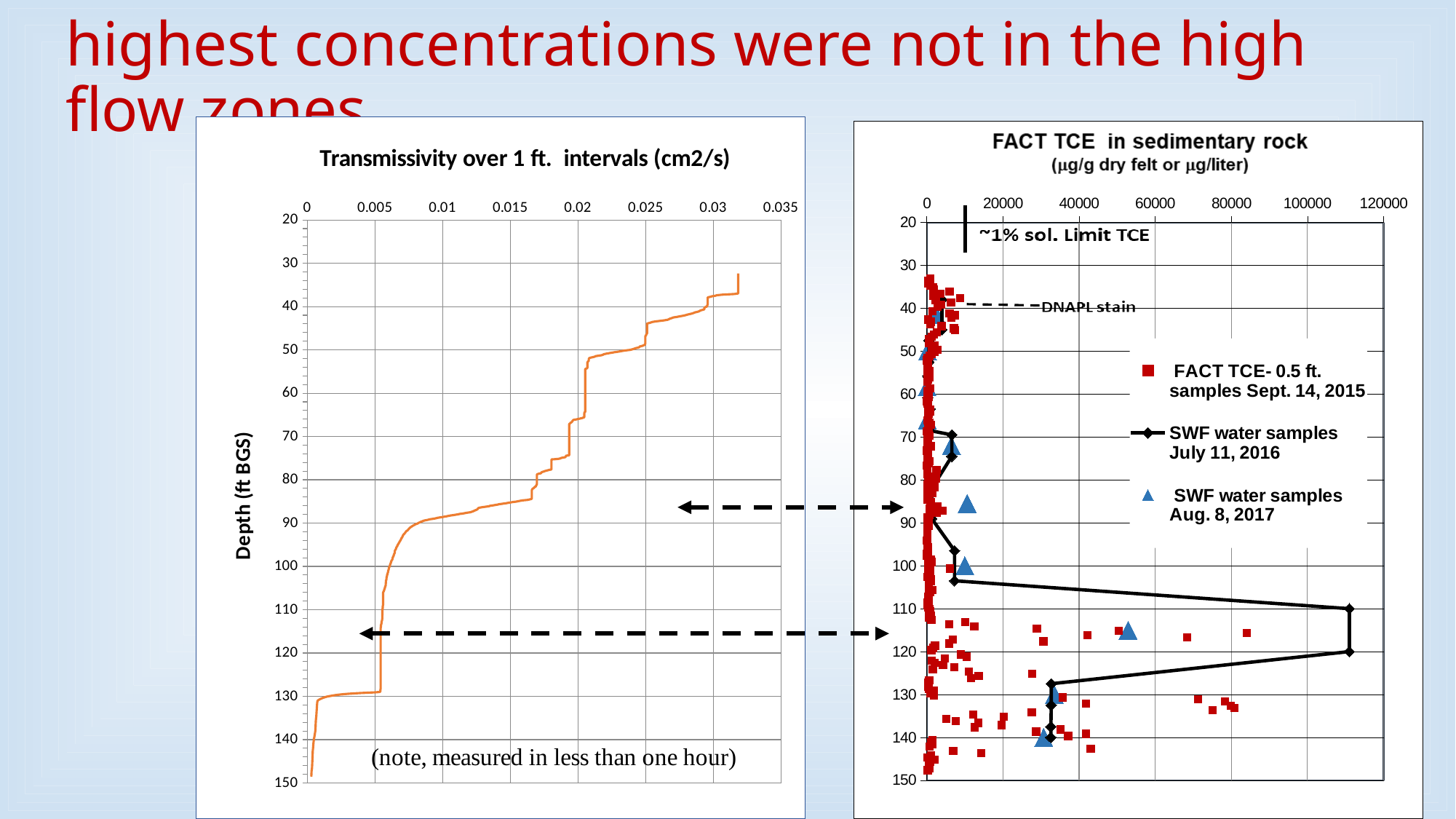
In the left chart, Transmissivity over 1 ft. intervals, is the transmissivity at a depth of 140 ft BGS greater or less than 0.005? less In the right chart, FACT TCE in sedimentary rock, is the SWF water samples July 11, 2016 value at a depth of 70 greater or less than 20000? less In the right chart, FACT TCE in sedimentary rock, is the SWF water samples July 11, 2016 value at a depth of 110 greater or less than 100000? greater In the left chart, Transmissivity over 1 ft. intervals, does transmissivity generally rise or fall as depth increases from 30 to 150 ft BGS? fall What is the label of the vertical axis on the left chart, Transmissivity over 1 ft. intervals? Depth (ft BGS) What kind of chart is the left chart titled "Transmissivity over 1 ft. intervals (cm2/s)"? line chart How many series does the legend of the right chart, FACT TCE in sedimentary rock, list? 3 In the right chart, FACT TCE in sedimentary rock, what is the highest value shown on the horizontal axis? 120000